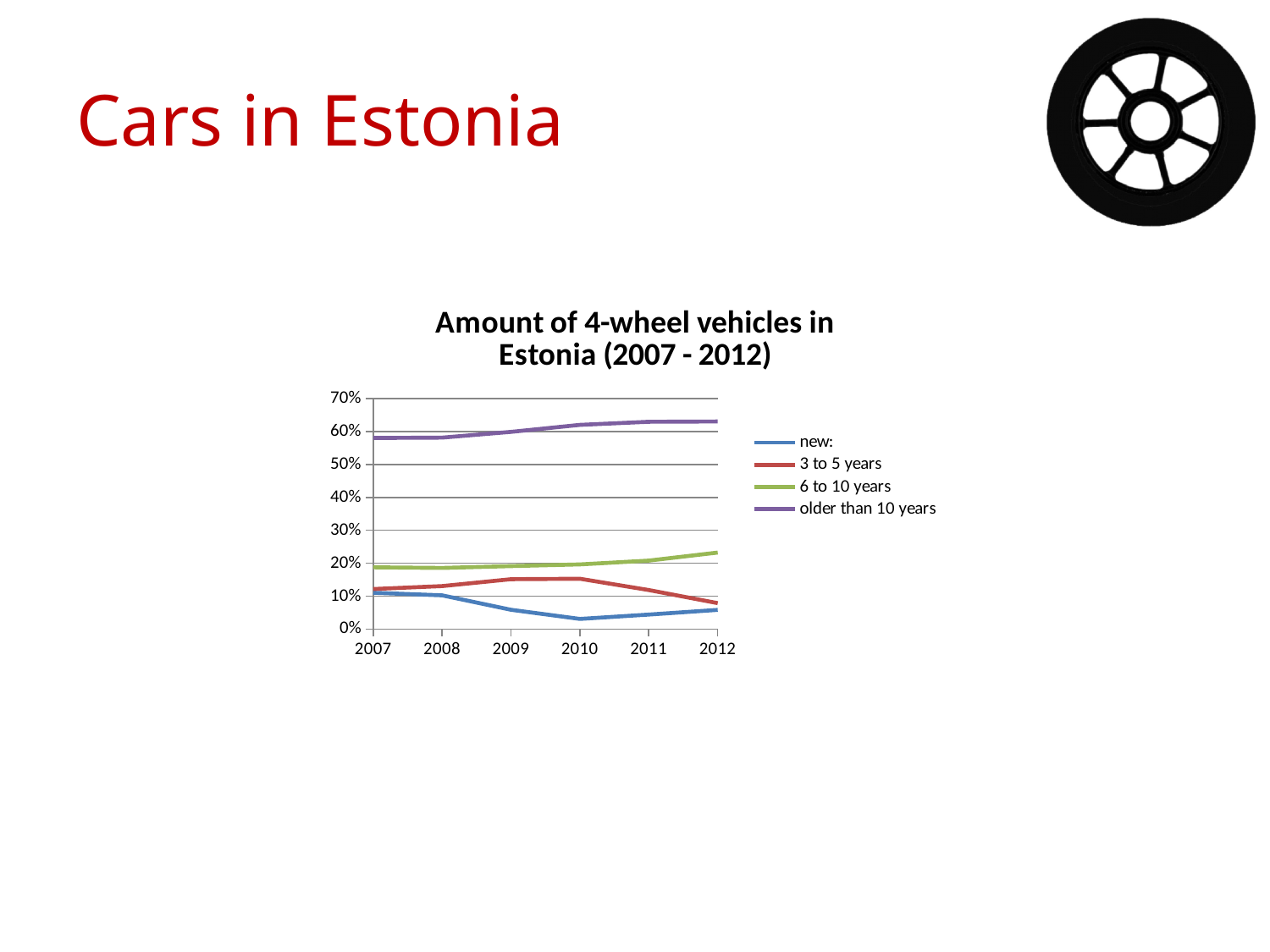
Is the value for 'new:' in 2010 greater or less than 10%? less Which series has the lowest value in 2010? new: What is the title of the chart? Amount of 4-wheel vehicles in Estonia (2007 - 2012) In 2012, which is larger: the value for '6 to 10 years' or the value for '3 to 5 years'? 6 to 10 years Which series has the highest value in 2012? older than 10 years Does the 'older than 10 years' series rise or fall from 2007 to 2012? rise Is the value for '6 to 10 years' in 2012 greater or less than 20%? greater How many years are shown along the x axis of the chart? 6 Does the 'new:' series rise or fall from 2007 to 2012? fall How many series does the chart's legend list? 4 Is the value for 'older than 10 years' in 2012 greater or less than 60%? greater What kind of chart is shown on the slide? line chart